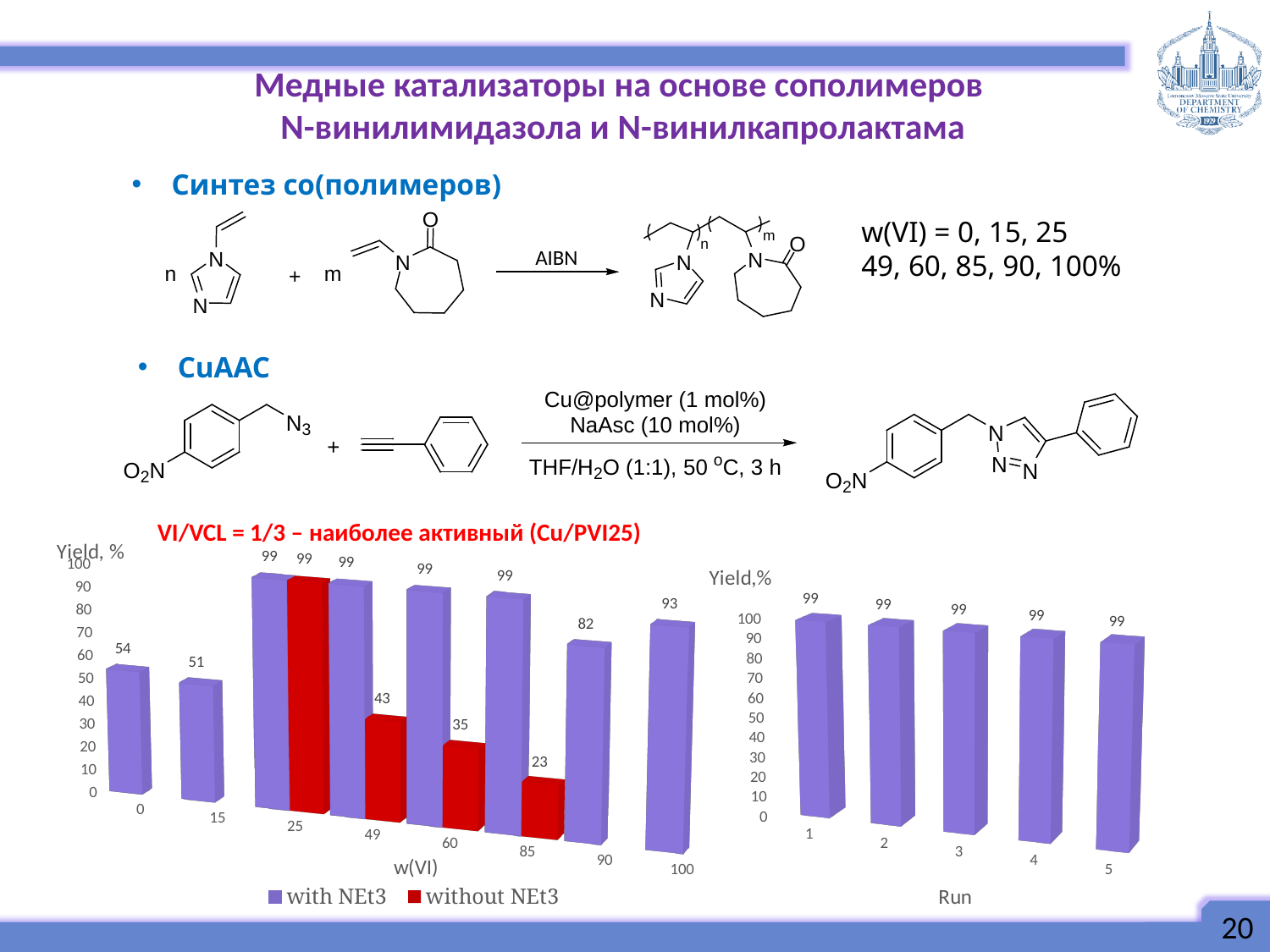
In the left chart (Yield vs w(VI)), what is the yield without NEt3 at w(VI) = 85? 23 In the right chart (Yield vs Run), what is the yield at Run 3? 99 In the left chart (Yield vs w(VI)), what is the yield with NEt3 at w(VI) = 0? 54 In the left chart (Yield vs w(VI)), how many series does the legend list? 2 In the left chart (Yield vs w(VI)), what is the yield without NEt3 at w(VI) = 49? 43 In the left chart (Yield vs w(VI)), how many w(VI) categories are shown on the x axis? 8 In the left chart (Yield vs w(VI)), what colour are the bars for the 'without NEt3' series? Red In the left chart (Yield vs w(VI)), at which w(VI) value is the yield without NEt3 the lowest? 85 In the right chart (Yield vs Run), how many runs are shown? 5 In the left chart (Yield vs w(VI)), what is the difference between the yields with and without NEt3 at w(VI) = 60? 64 In the left chart (Yield vs w(VI)), what is the yield with NEt3 at w(VI) = 90? 82 In the left chart (Yield vs w(VI)), which is larger: the yield with NEt3 at w(VI) = 15 or at w(VI) = 100? w(VI) = 100